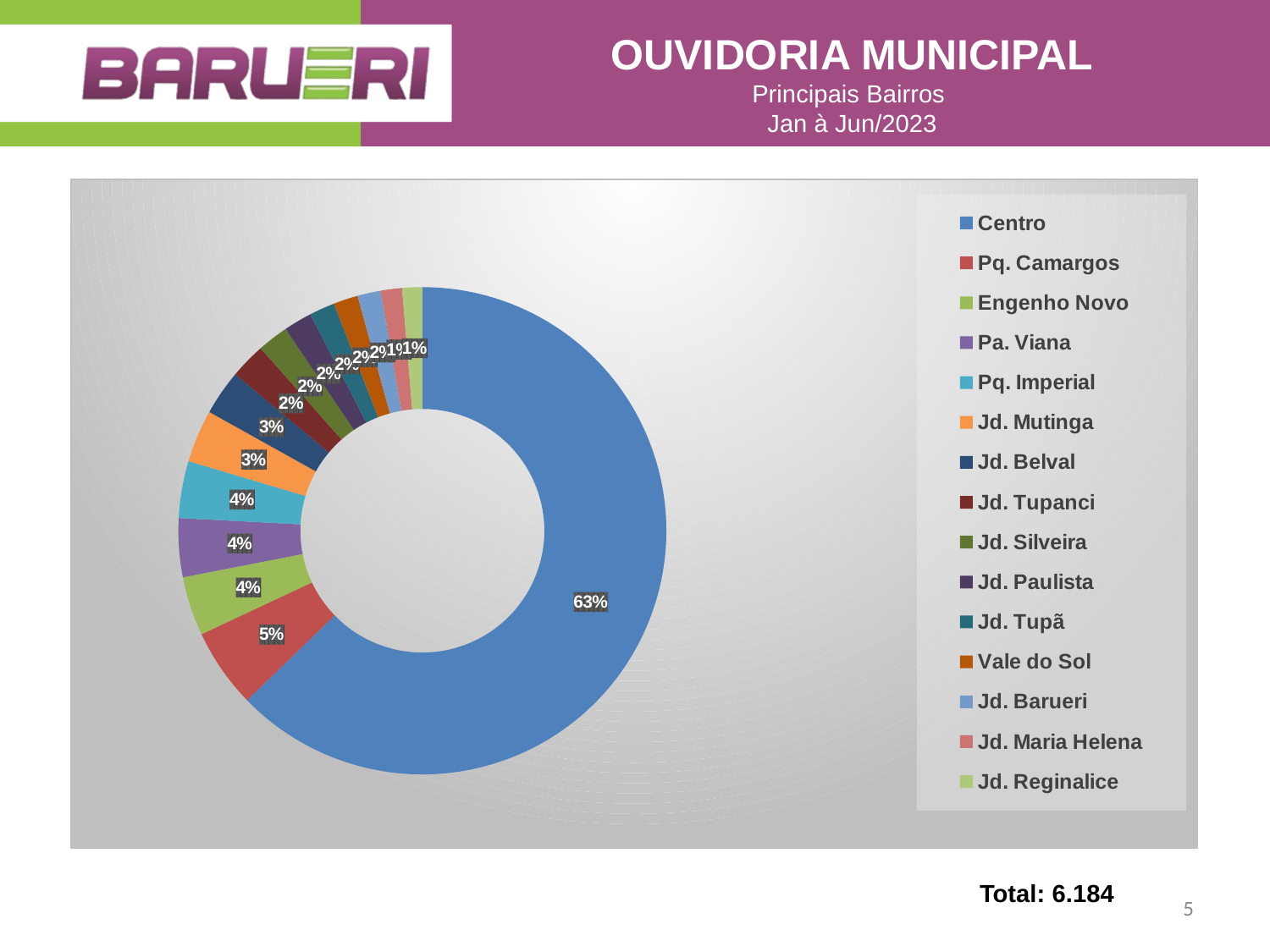
What percentage is shown for Pq. Imperial? 4% What percentage is shown for Pq. Camargos? 5% Which neighbourhood is listed last in the legend? Jd. Reginalice What is the difference in percentage points between Centro and Pq. Camargos? 58 percentage points Which neighbourhood has the largest slice of the pie? Centro What kind of chart is shown on the slide? doughnut chart What percentage is shown for Jd. Belval? 3% What total is printed below the chart? 6.184 What percentage is shown for Jd. Mutinga? 3% How many neighbourhoods are listed in the chart legend? 15 What share of the pie does Centro account for? 63% Which has a larger share, Pq. Camargos or Engenho Novo? Pq. Camargos